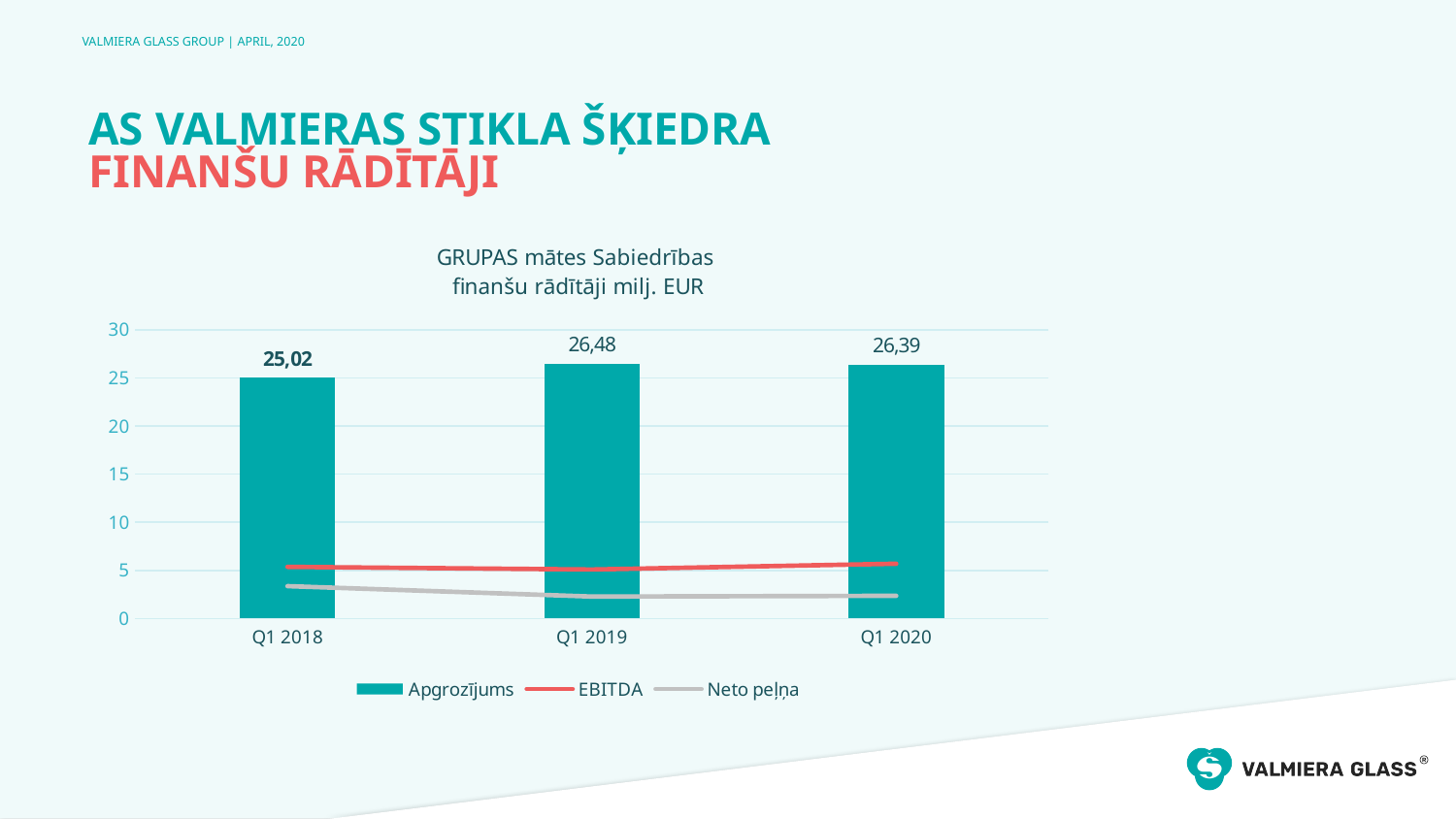
What is the title of the chart? GRUPAS mātes Sabiedrības finanšu rādītāji milj. EUR Is the EBITDA value for Q1 2020 greater or less than 10? less What is the Apgrozījums value for Q1 2019? 26,48 Which quarter has the highest Apgrozījums? Q1 2019 What is the difference in Apgrozījums between Q1 2019 and Q1 2018? 1,46 Which is larger, the Apgrozījums for Q1 2020 or for Q1 2018? Q1 2020 What is the Apgrozījums value for Q1 2018? 25,02 What is the Apgrozījums value for Q1 2020? 26,39 How many quarters are shown on the x axis? 3 How many series does the legend list? 3 Is the Neto peļņa value for Q1 2019 greater or less than 5? less Which quarter has the lowest Apgrozījums? Q1 2018